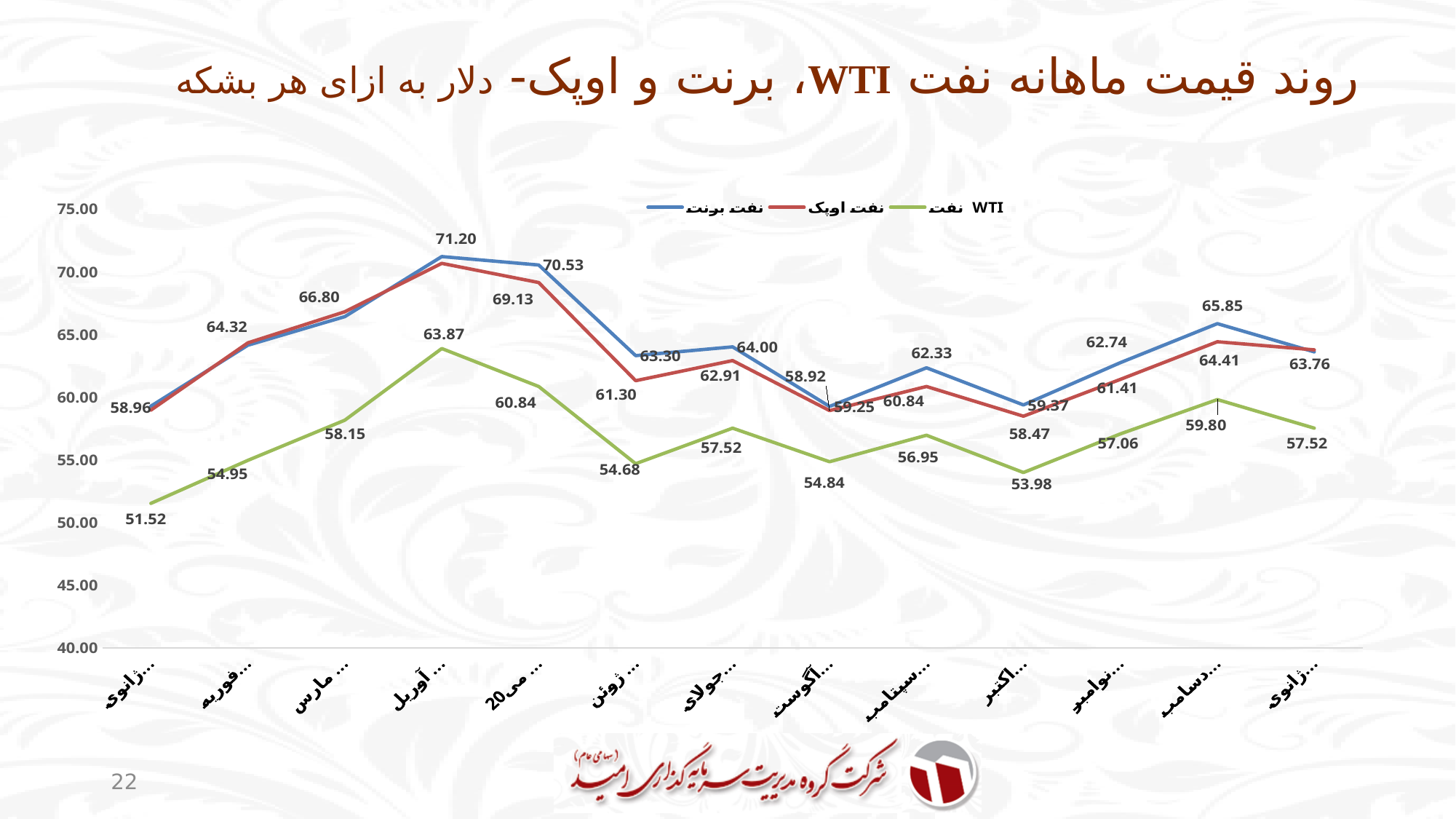
What is the lowest value of نفت WTI on the chart? 51.52 How many series does the legend list? 3 What kind of chart is shown on the slide? line chart What is the value of نفت WTI at the first ژانوی point? 51.52 Which is larger for نفت WTI: the value in آوریل or the value in می? آوریل What is the difference between the نفت WTI value in آوریل and its value at the first ژانوی point? 12.35 What is the value of نفت WTI in دسامبر? 59.80 In which month does نفت WTI reach its highest value? آوریل Is the value for نفت برنت in آوریل greater or less than 70.00? greater How many months (points) are plotted along the x axis? 13 What is the value of نفت WTI in اکتبر? 53.98 Does نفت WTI rise or fall from the first ژانوی point to آوریل? rise